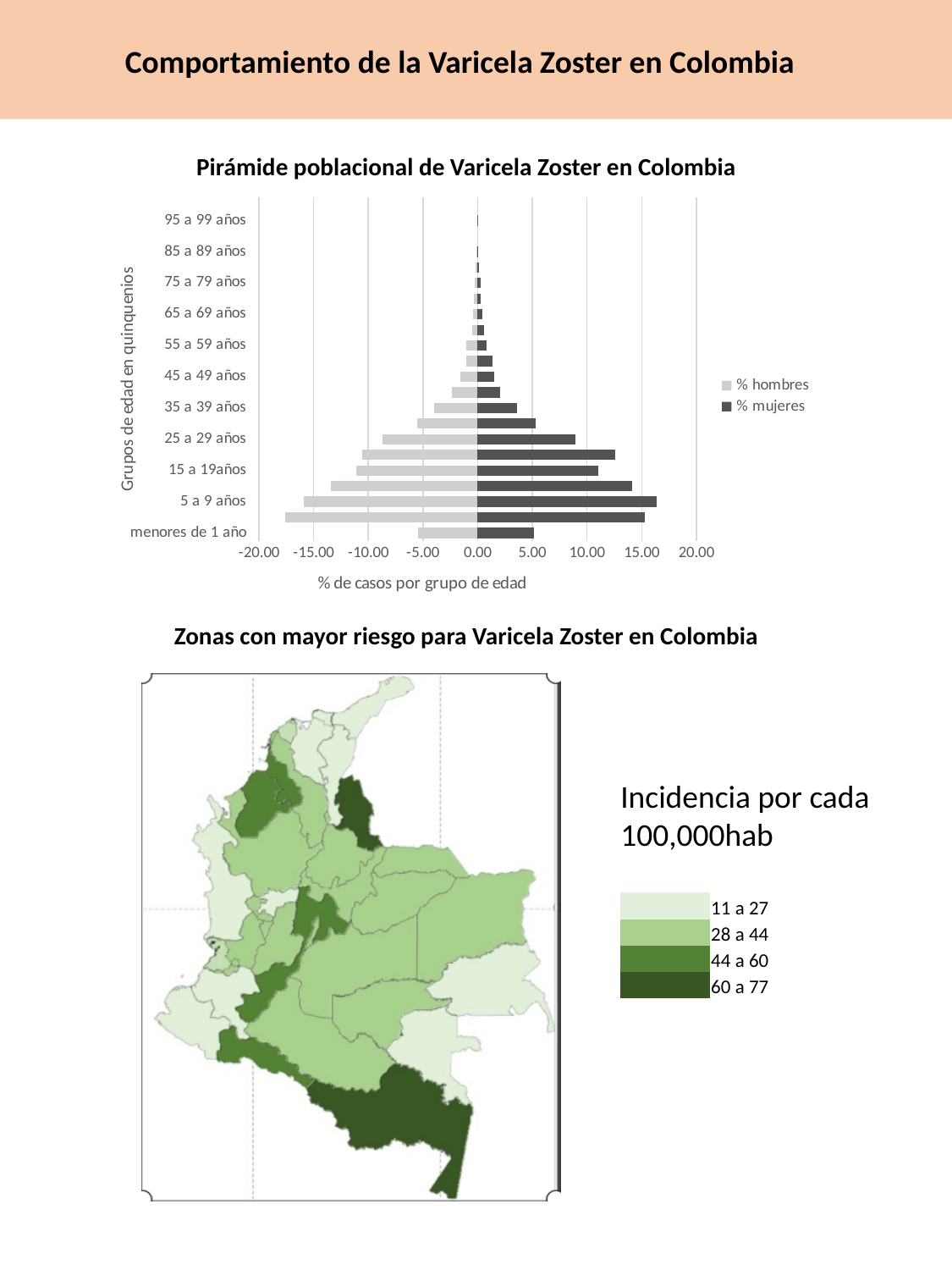
In the 'Pirámide poblacional de Varicela Zoster en Colombia' chart, which has the larger % mujeres value: 5 a 9 años or 25 a 29 años? 5 a 9 años In the 'Pirámide poblacional de Varicela Zoster en Colombia' chart, which series is shown in dark gray? % mujeres In the 'Pirámide poblacional de Varicela Zoster en Colombia' chart, is the % mujeres value for 15 a 19 años greater or less than 10.00? greater In the 'Pirámide poblacional de Varicela Zoster en Colombia' chart, is the % mujeres value for 35 a 39 años greater or less than 5.00? less How many series does the legend of the 'Pirámide poblacional de Varicela Zoster en Colombia' chart list? 2 In the 'Pirámide poblacional de Varicela Zoster en Colombia' chart, is the % mujeres value for 5 a 9 años greater or less than 15.00? greater In the 'Pirámide poblacional de Varicela Zoster en Colombia' chart, which labeled age group has the highest % mujeres value? 5 a 9 años In the 'Pirámide poblacional de Varicela Zoster en Colombia' chart, what is the title of the horizontal axis? % de casos por grupo de edad In the 'Pirámide poblacional de Varicela Zoster en Colombia' chart, do the % mujeres values rise or fall as the age groups go from 5 a 9 años up to 95 a 99 años? fall What kind of chart is 'Pirámide poblacional de Varicela Zoster en Colombia'? bar chart